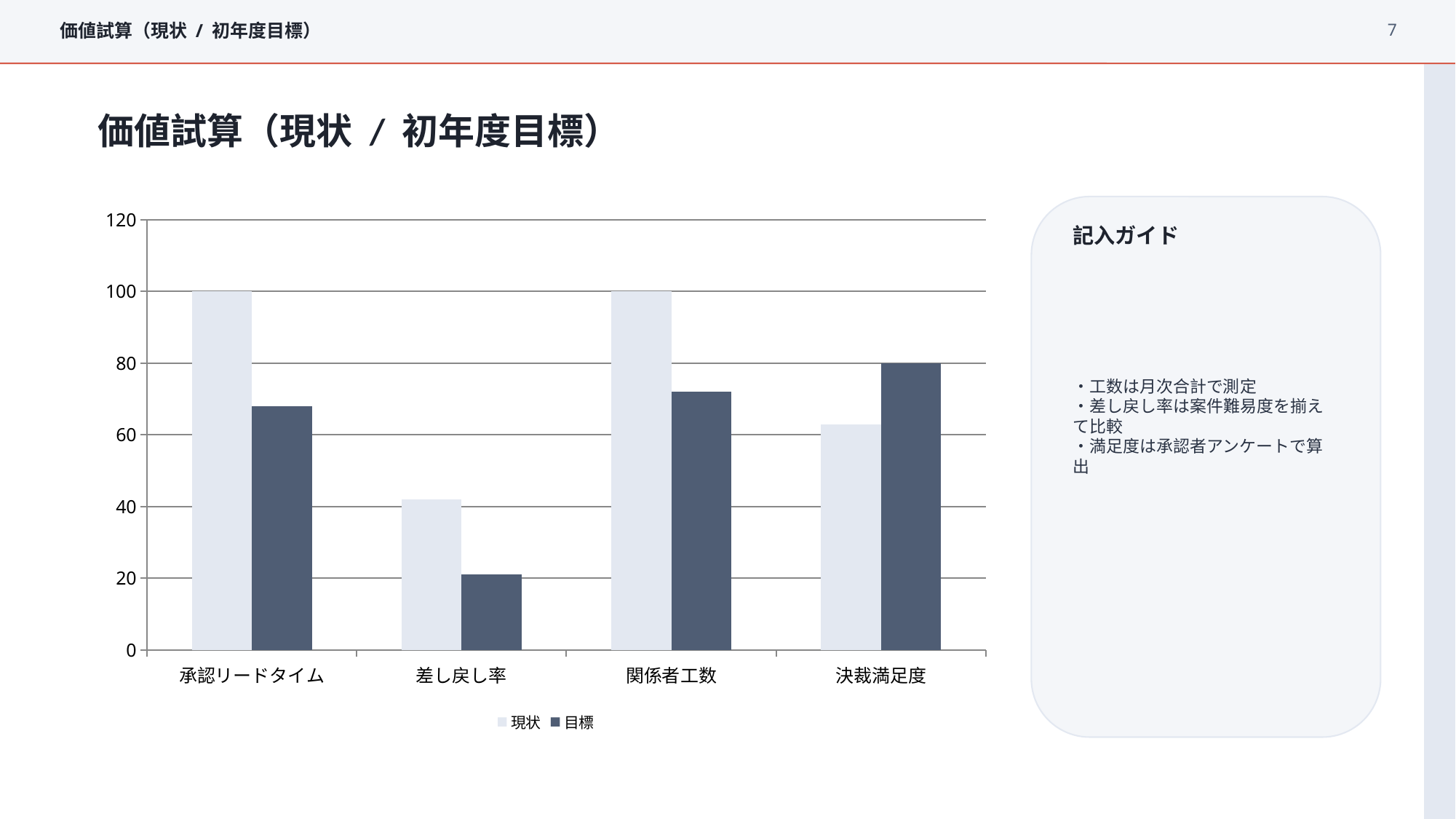
For 決裁満足度, which is larger, the 現状 value or the 目標 value? 目標 Which category has the lowest 目標 value? 差し戻し率 How many categories are shown on the x axis of the chart? 4 What is the 現状 value for 関係者工数? 100 Which category has the lowest 現状 value? 差し戻し率 Is the 現状 value for 差し戻し率 greater or less than 40? greater What is the 目標 value for 決裁満足度? 80 What kind of chart is shown on the slide? bar chart What is the 現状 value for 承認リードタイム? 100 Is the 目標 value for 承認リードタイム greater or less than 60? greater What are the two series named in the chart's legend? 現状 and 目標 How many series does the chart's legend list? 2